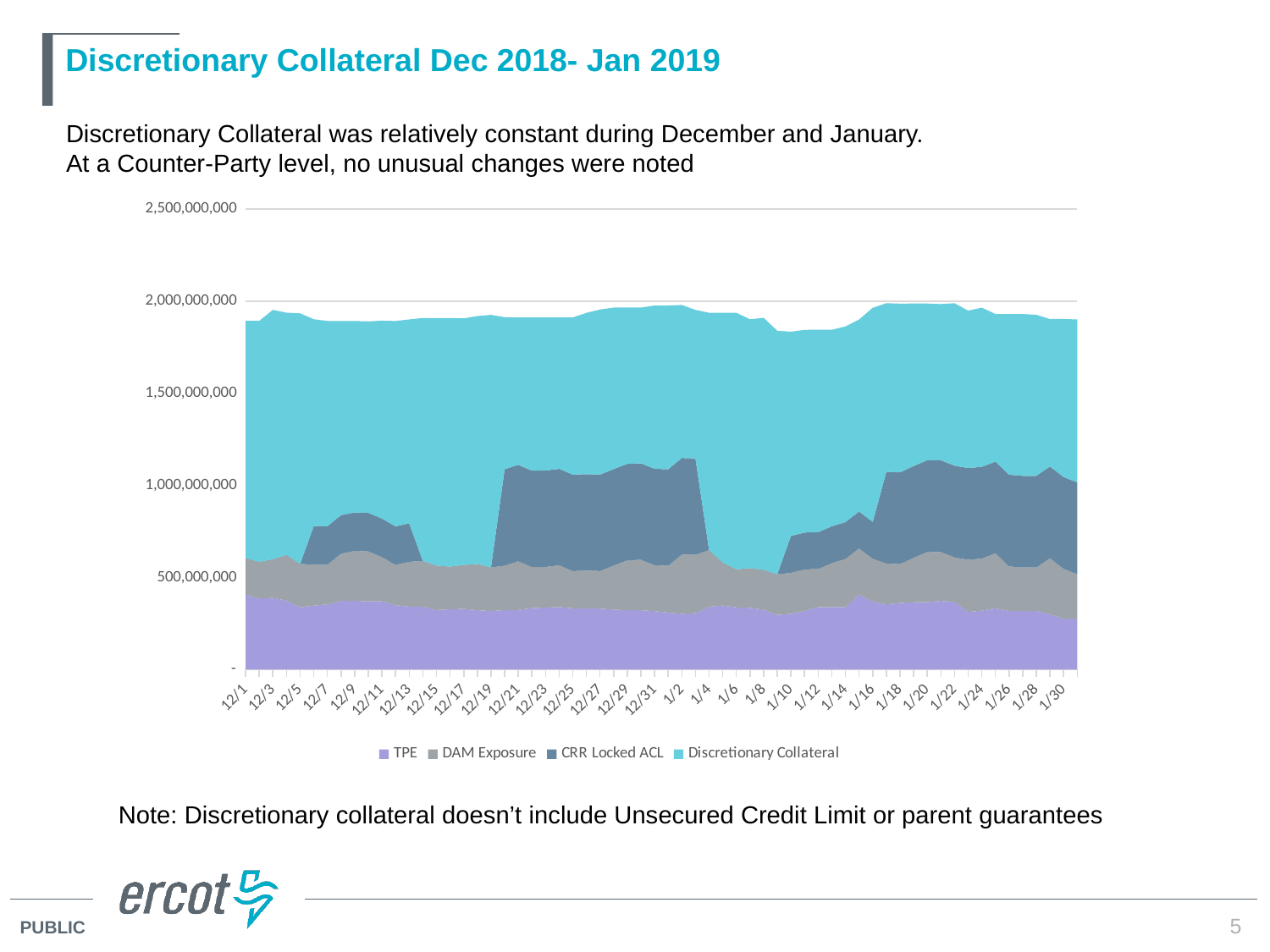
Which series is plotted at the bottom of the stack? TPE What kind of chart is shown on the slide? Stacked area chart Is the total stacked value on 1/10 greater or less than 1,500,000,000? greater Does the total stacked value rise sharply, fall sharply, or stay roughly flat from 12/1 to 1/30? Stays roughly flat How many series does the legend list? 4 Which series is plotted at the top of the stack? Discretionary Collateral Is the total stacked value on 12/1 greater or less than 2,000,000,000? less Which series takes up the largest share of the stacked area across the period? Discretionary Collateral What is the highest value shown on the y axis? 2,500,000,000 Is the top of the CRR Locked ACL band on 12/29 greater or less than 1,000,000,000? greater